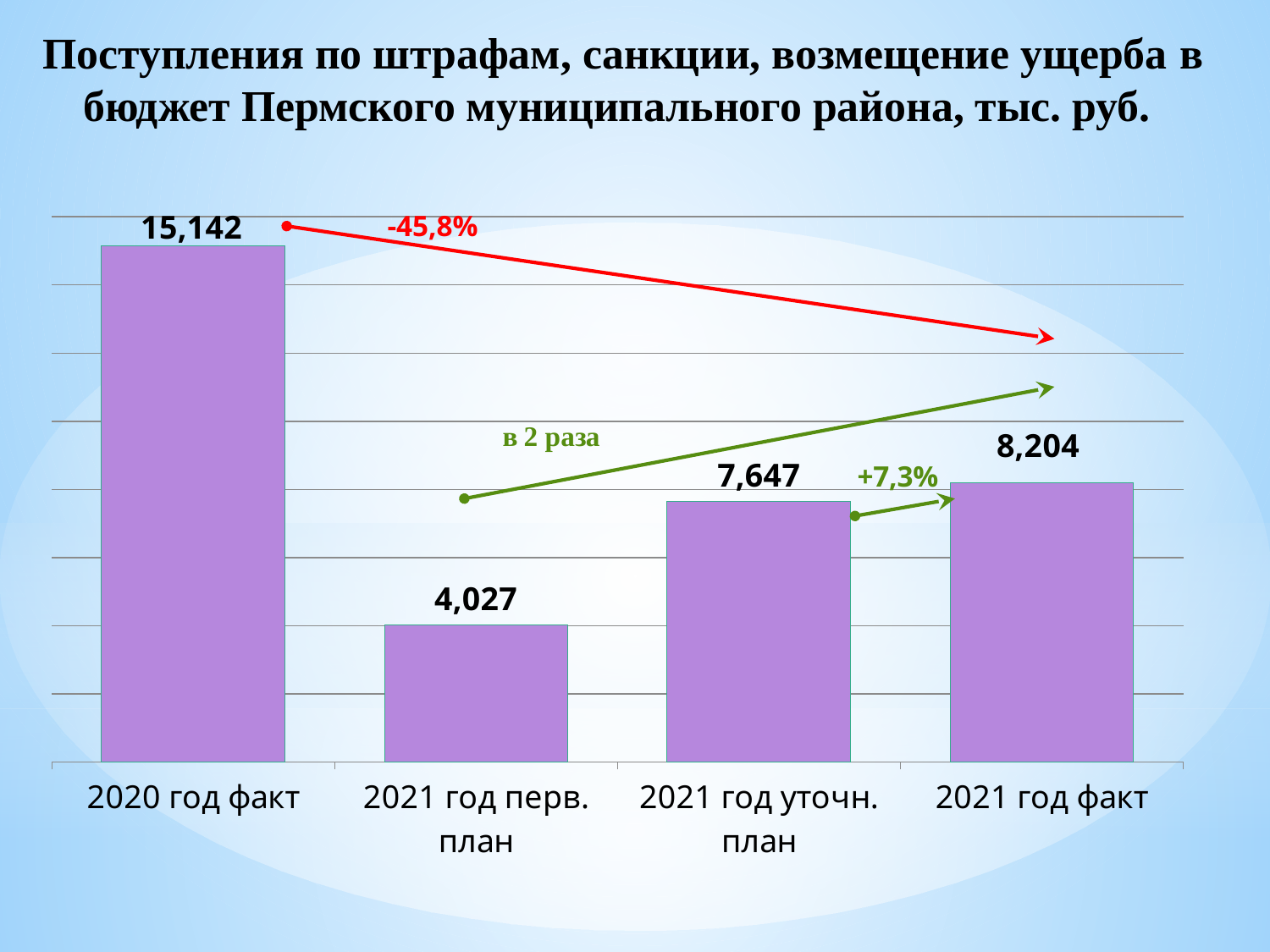
What kind of chart is shown on the slide? bar chart What is the difference between the values for 2020 год факт and 2021 год перв. план? 11,115 Which category has the highest value? 2020 год факт What percentage change is written on the red arrow between 2020 год факт and 2021 год факт? -45,8% What is the value for 2021 год перв. план? 4,027 Which category has the lowest value? 2021 год перв. план What is the value for 2020 год факт? 15,142 Which is larger, the value for 2021 год уточн. план or the value for 2021 год факт? 2021 год факт How many categories are shown on the x axis? 4 What is the value for 2021 год факт? 8,204 What is the value for 2021 год уточн. план? 7,647 What is the difference between the values for 2021 год факт and 2021 год уточн. план? 557